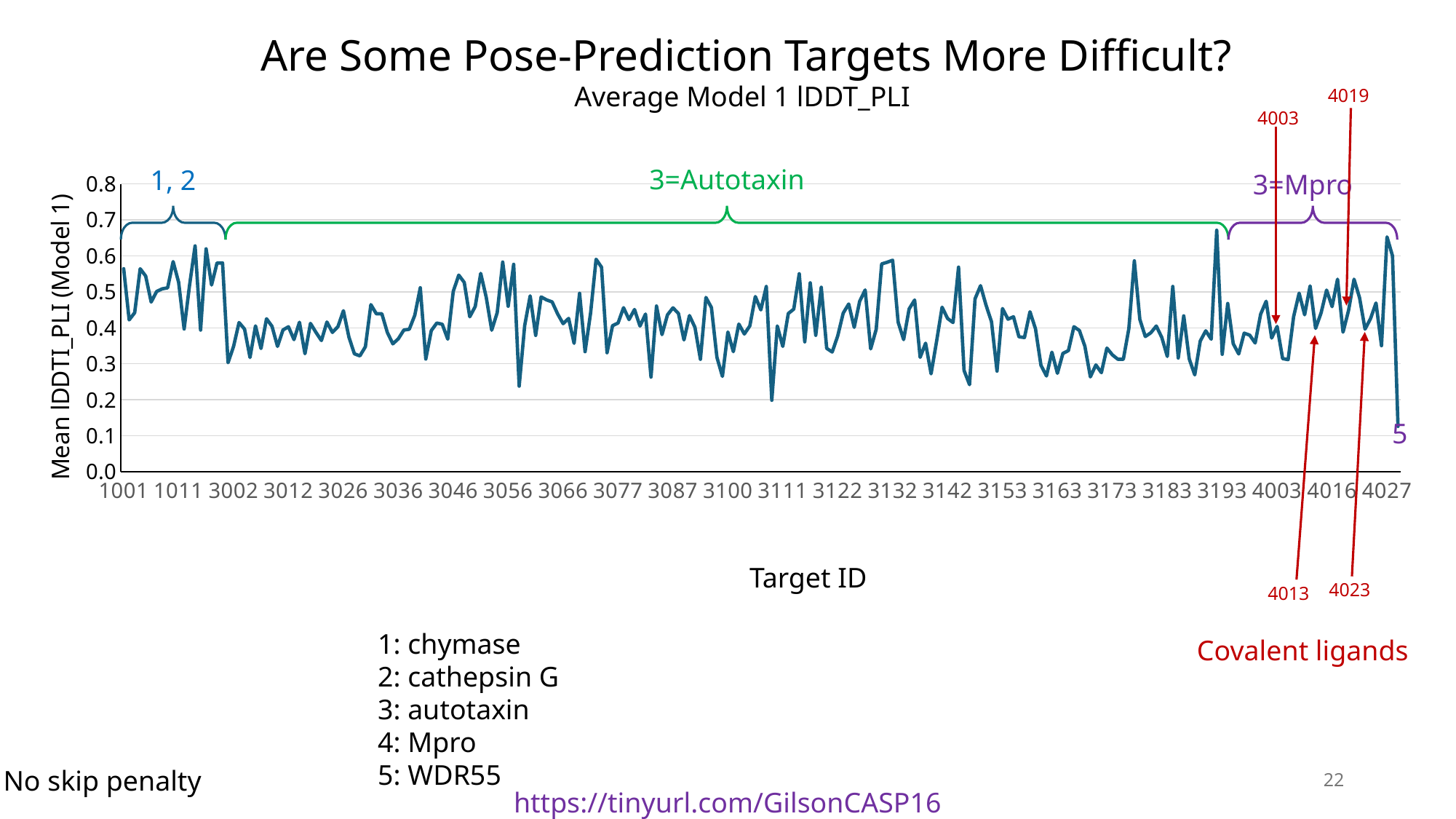
Is the value for the first target (1001) greater or less than 0.5? greater Which target group has the lowest Mean lDDT_PLI value on the chart? 5 (WDR55) How many data series are plotted in the chart? 1 What is the highest tick value shown on the y axis? 0.8 What is the label of the x axis? Target ID Is the value for target 4019 greater or less than 0.4? greater Does any point on the chart exceed 0.7? No What kind of chart is shown on the slide? Line chart What is the title printed directly above the chart? Average Model 1 lDDT_PLI Which is larger, the value for target 1001 or the value for the last target (WDR55)? 1001